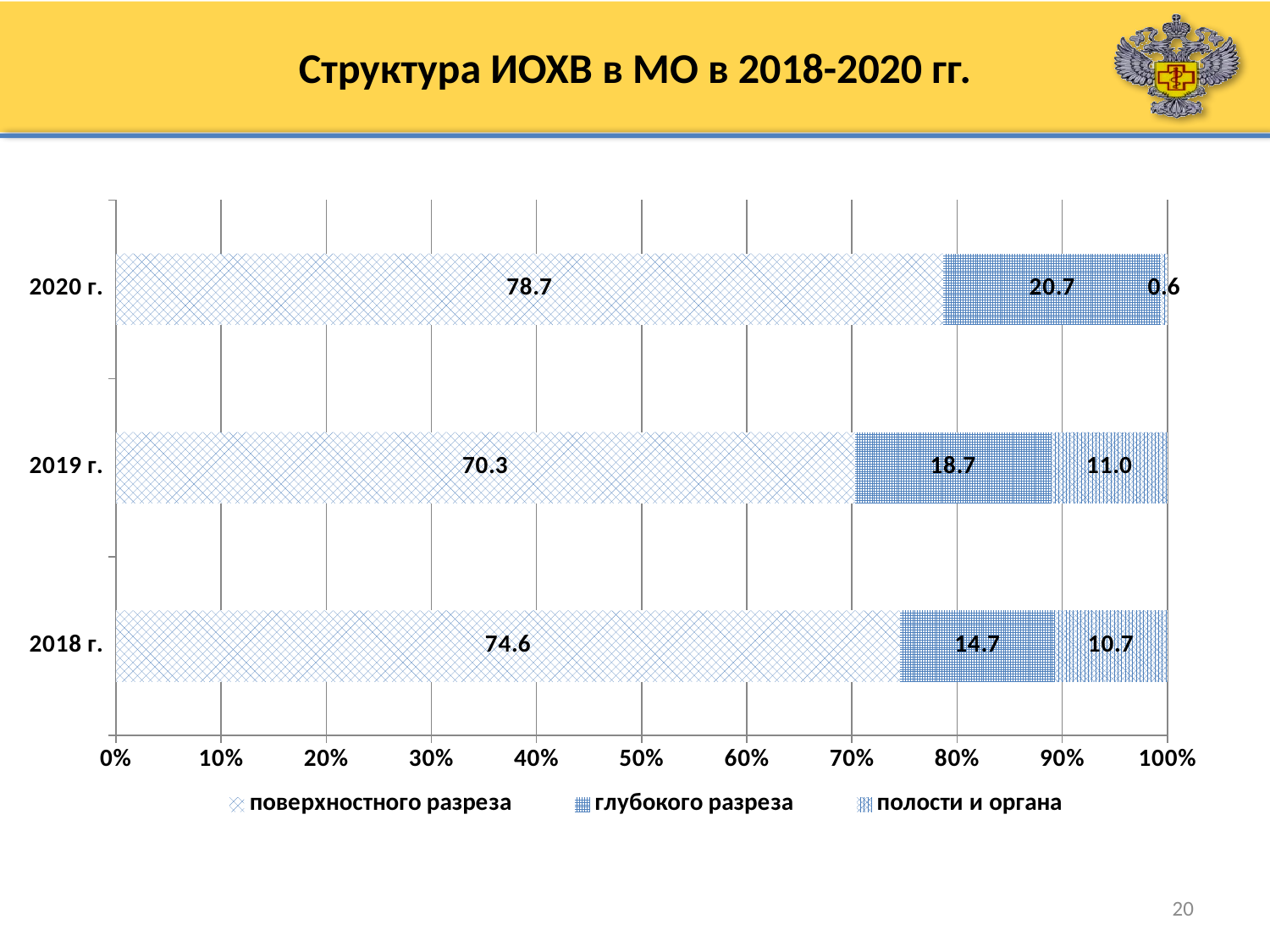
What kind of chart is shown on the slide? Stacked bar chart What is the value for "поверхностного разреза" in 2020 г.? 78.7 What is the difference between the "глубокого разреза" values for 2020 г. and 2018 г.? 6.0 Which year has the lowest value for "глубокого разреза"? 2018 г. What is the value for "глубокого разреза" in 2019 г.? 18.7 Which year has the highest value for "поверхностного разреза"? 2020 г. What is the value for "полости и органа" in 2018 г.? 10.7 What is the value for "полости и органа" in 2020 г.? 0.6 How many series does the legend list? 3 What is the title of the slide? Структура ИОХВ в МО в 2018-2020 гг. Which is larger: the "полости и органа" value for 2019 г. or for 2018 г.? 2019 г. How many years (categories) are shown on the chart? 3